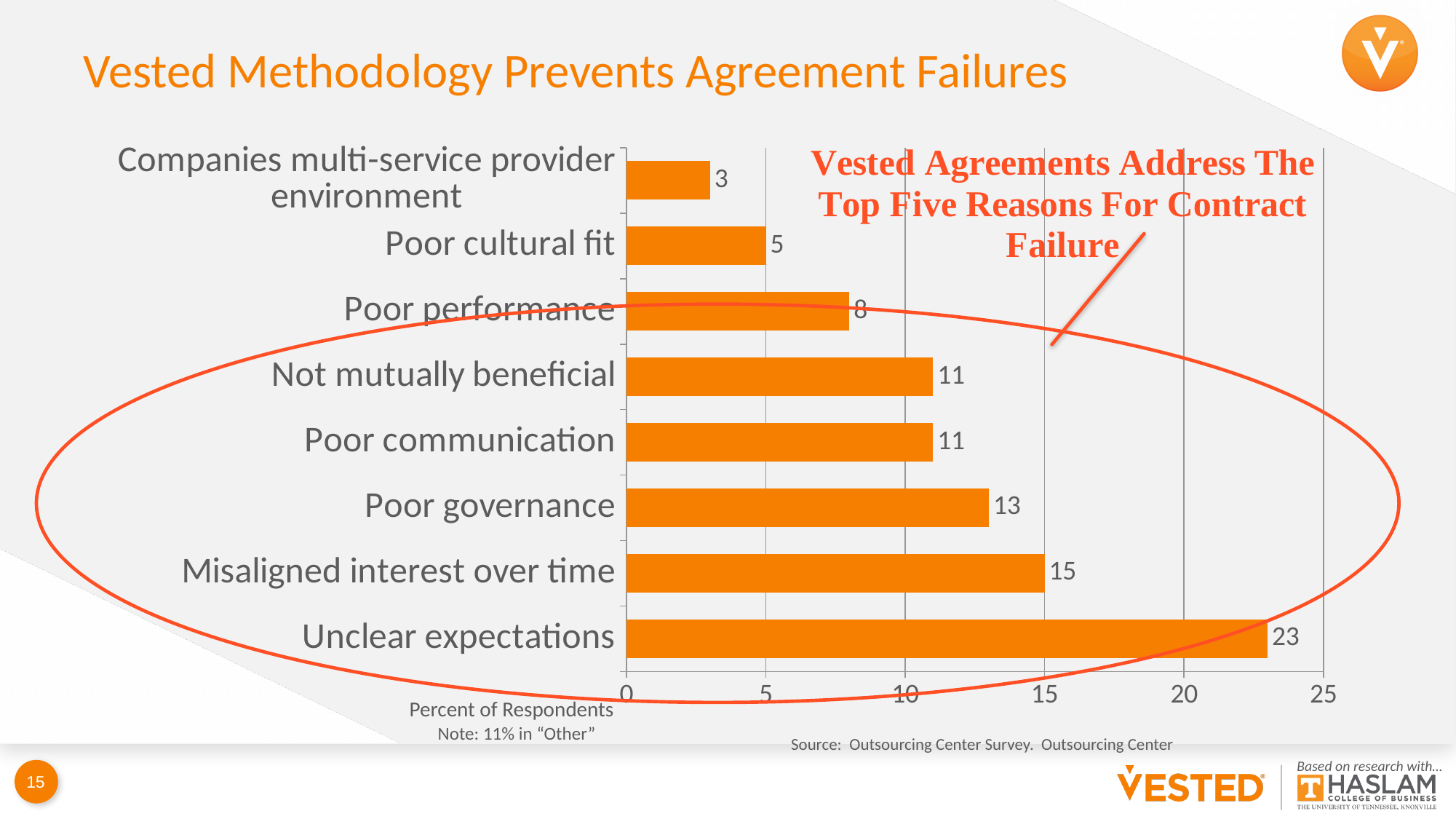
Is the value for Misaligned interest over time greater or less than 20? less What is the difference between the values for Unclear expectations and Misaligned interest over time? 8 What is the label on the horizontal axis of the chart? Percent of Respondents What kind of chart is shown on the slide? bar chart Which is larger, the value for Poor performance or the value for Poor governance? Poor governance Which category has the lowest value? Companies multi-service provider environment What is the value for Poor governance? 13 Which category has the highest value? Unclear expectations What is the value for Not mutually beneficial? 11 What is the value for Unclear expectations? 23 How many categories are shown in the chart? 8 What is the value for Poor cultural fit? 5